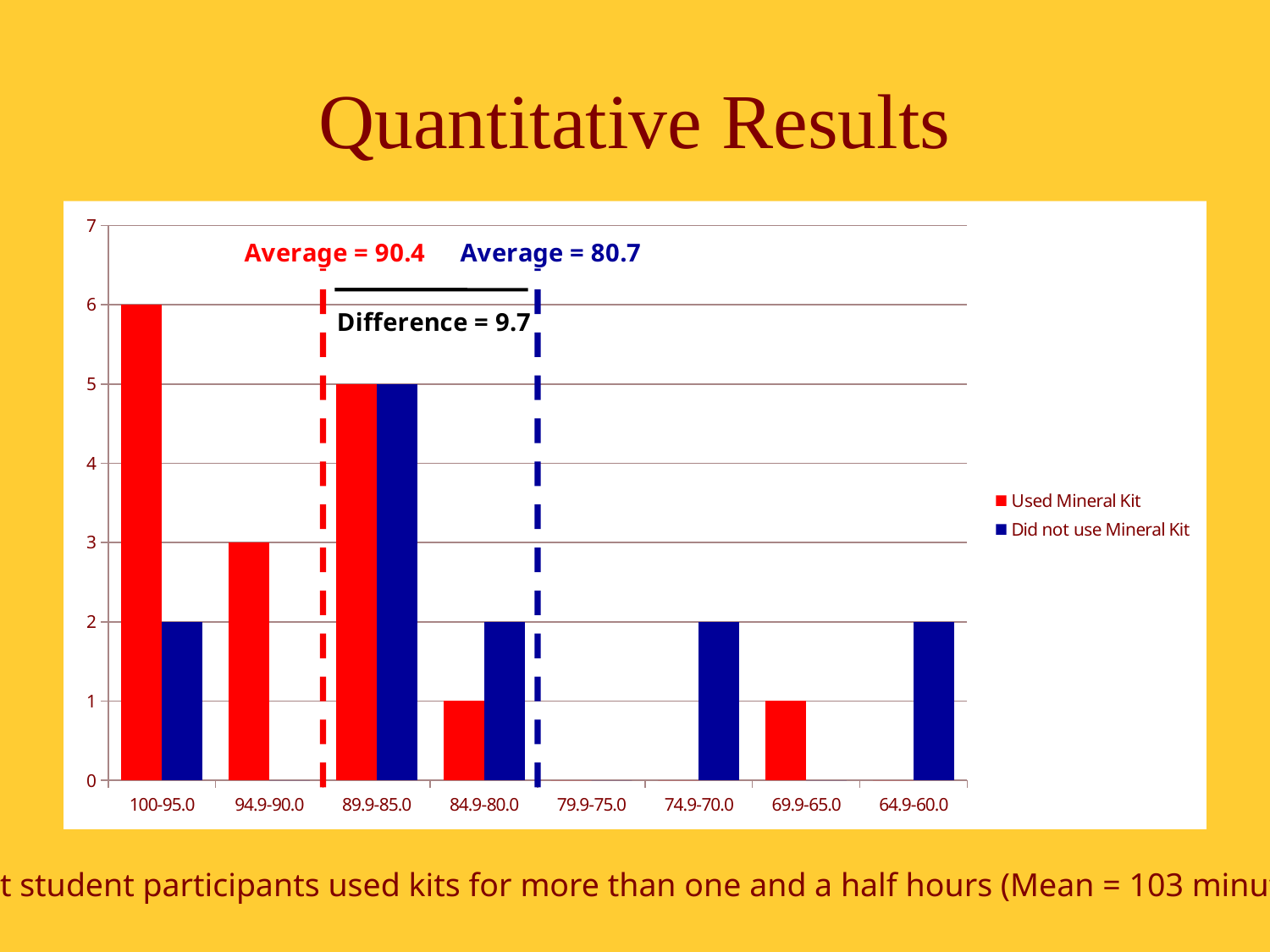
What is the value for Did not use Mineral Kit in the 100-95.0 category? 2 How many score-range categories are shown on the x axis? 8 In the 84.9-80.0 category, which series has the larger value, Used Mineral Kit or Did not use Mineral Kit? Did not use Mineral Kit What kind of chart is shown on the slide? bar chart What is the value for Used Mineral Kit in the 100-95.0 category? 6 Which category has the highest value for Used Mineral Kit? 100-95.0 How many series does the legend list? 2 What is the value for Used Mineral Kit in the 94.9-90.0 category? 3 What is the value for Did not use Mineral Kit in the 89.9-85.0 category? 5 What is the difference between the Used Mineral Kit and Did not use Mineral Kit values in the 100-95.0 category? 4 What difference between the two group averages is labelled on the chart? 9.7 What average is shown for the Used Mineral Kit group? 90.4